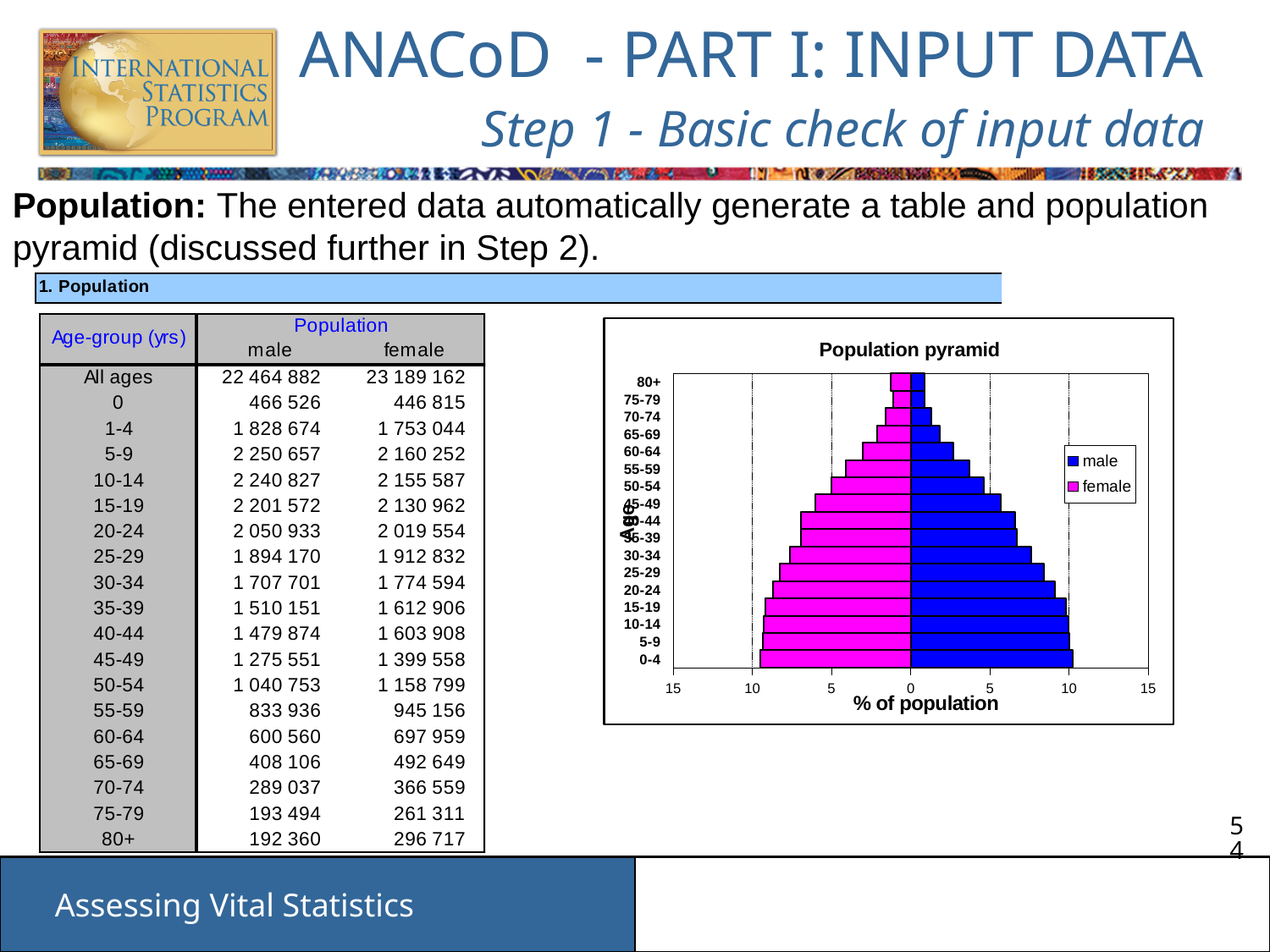
In the Population pyramid chart, which is larger for females: the 15-19 age group or the 70-74 age group? 15-19 How many series does the legend of the Population pyramid chart list? 2 What colour represents the female series in the Population pyramid chart? magenta In the Population pyramid chart, is the female value for the 0-4 age group greater or less than 10? less In the Population pyramid chart, do the bars generally get longer or shorter as the age group increases from 0-4 to 80+? shorter In the Population pyramid chart, is the female value for the 30-34 age group greater or less than 5? greater What is the title of the chart on the slide? Population pyramid How many age-group categories are shown on the Population pyramid chart? 17 In the Population pyramid chart, which is larger for males: the 0-4 age group or the 80+ age group? 0-4 In the Population pyramid chart, is the male value for the 80+ age group greater or less than 5? less What kind of chart is the Population pyramid? bar chart